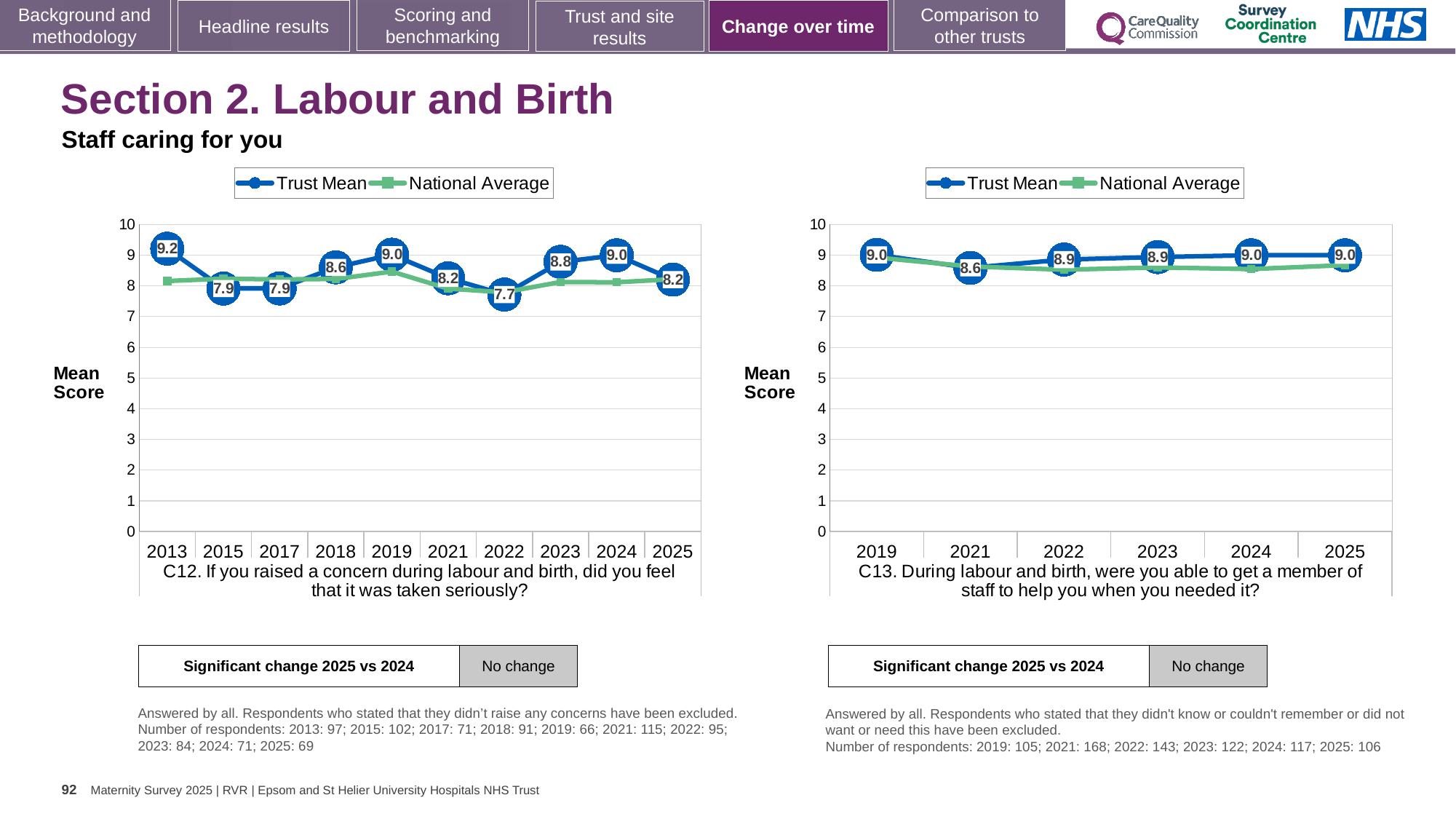
In the C12 chart on the left, which year has the lowest Trust Mean score? 2022 In the C12 chart on the left, how many years are shown on the x axis? 10 In the C12 chart on the left, is the National Average value for 2013 greater or less than 9? less In the C12 chart on the left, which year has the highest Trust Mean score? 2013 In the C13 chart on the right, what is the Trust Mean score for 2021? 8.6 In the C12 chart on the left, what is the difference between the Trust Mean scores for 2024 and 2025? 0.8 In the C13 chart on the right, is the Trust Mean score for 2019 larger or smaller than the score for 2021? larger In the C13 chart on the right, how many years are shown on the x axis? 6 In the C13 chart on the right, which year has the lowest Trust Mean score? 2021 What kind of chart is the C12 chart on the left? Line chart In the C12 chart on the left, what is the Trust Mean score for 2013? 9.2 How many series does the legend of the C13 chart on the right list? 2